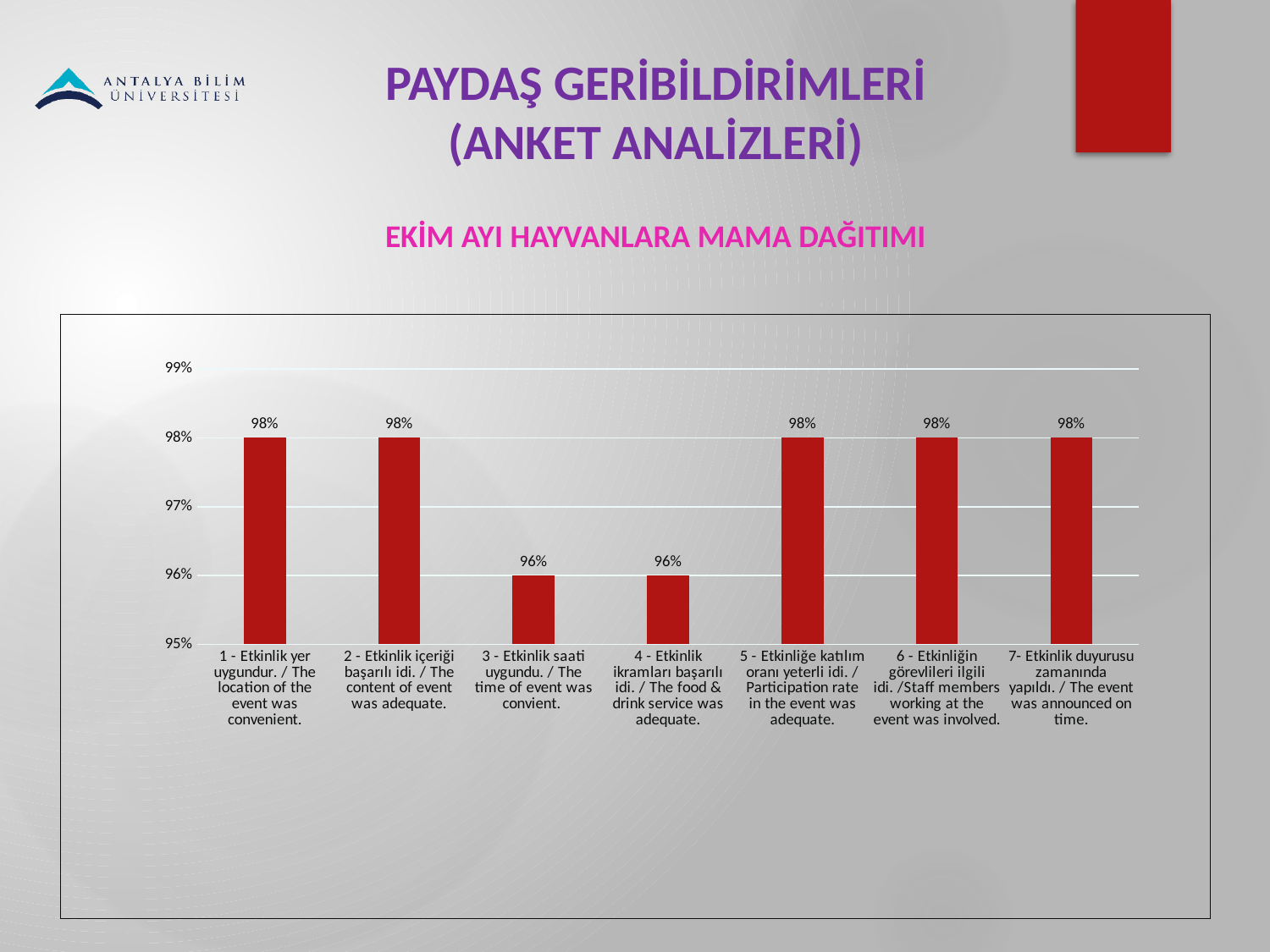
Which is larger: the value for category 5 (Participation rate) or the value for category 4 (food & drink service)? Category 5 (Participation rate) What is the difference between the value for category 2 and the value for category 3? 2% What is the value for category 7 (Etkinlik duyurusu zamanında yapıldı / The event was announced on time)? 98% Is the value for category 3 (time of event) greater or less than 97%? less What is the value for category 4 (Etkinlik ikramları başarılı idi / The food & drink service was adequate)? 96% What colour are the bars in the chart? Red Which categories have the lowest value in the chart? 3 and 4 (Etkinlik saati uygundu; Etkinlik ikramları başarılı idi) How many categories are shown in the chart? 7 What is the value for category 3 (Etkinlik saati uygundu / The time of event was convient)? 96% What is the highest value shown on the chart's vertical axis? 99% What kind of chart is shown on the slide? Bar chart What is the value for category 1 (Etkinlik yer uygundur / The location of the event was convenient)? 98%